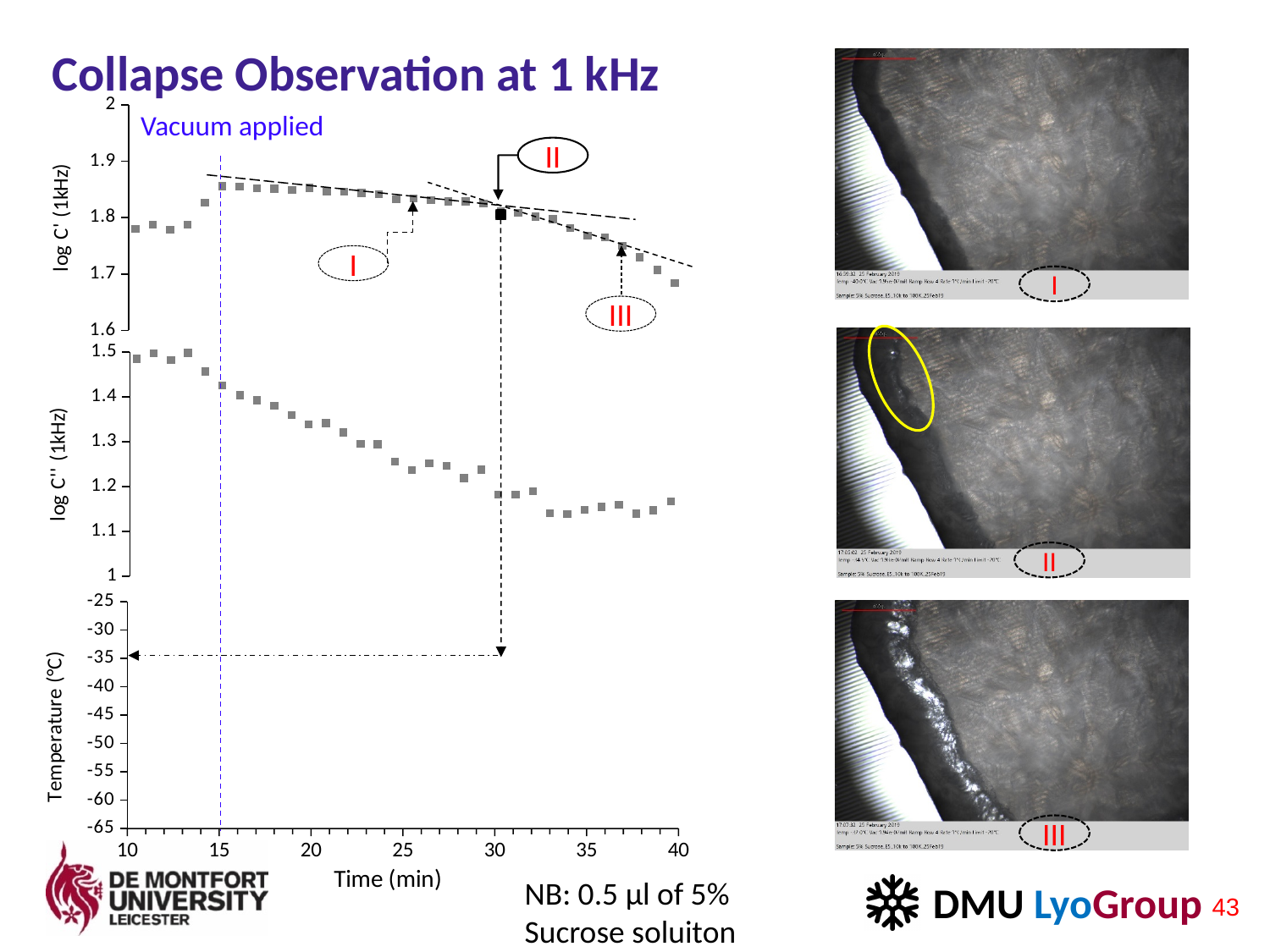
Does log C'' (1kHz) generally rise or fall as time increases from 15 to 30 minutes? fall What kind of chart is used to plot log C' and log C'' against time? scatter chart What is the title of the chart on the slide? Collapse Observation at 1 kHz Is log C' (1kHz) at 15 minutes larger or smaller than log C' (1kHz) at 38 minutes? larger What is the label of the x axis of the chart? Time (min) Is the value of log C'' (1kHz) at 35 minutes greater or less than 1.2? less Is the value of log C' (1kHz) at 39 minutes greater or less than 1.8? less Does log C' (1kHz) rise or fall as time increases from 30 to 40 minutes? fall At what time (in minutes) does the dashed vertical line marking 'Vacuum applied' appear on the chart? 15 Is the value of log C'' (1kHz) at 10 minutes greater or less than 1.4? greater What is the maximum value shown on the Time (min) axis of the chart? 40